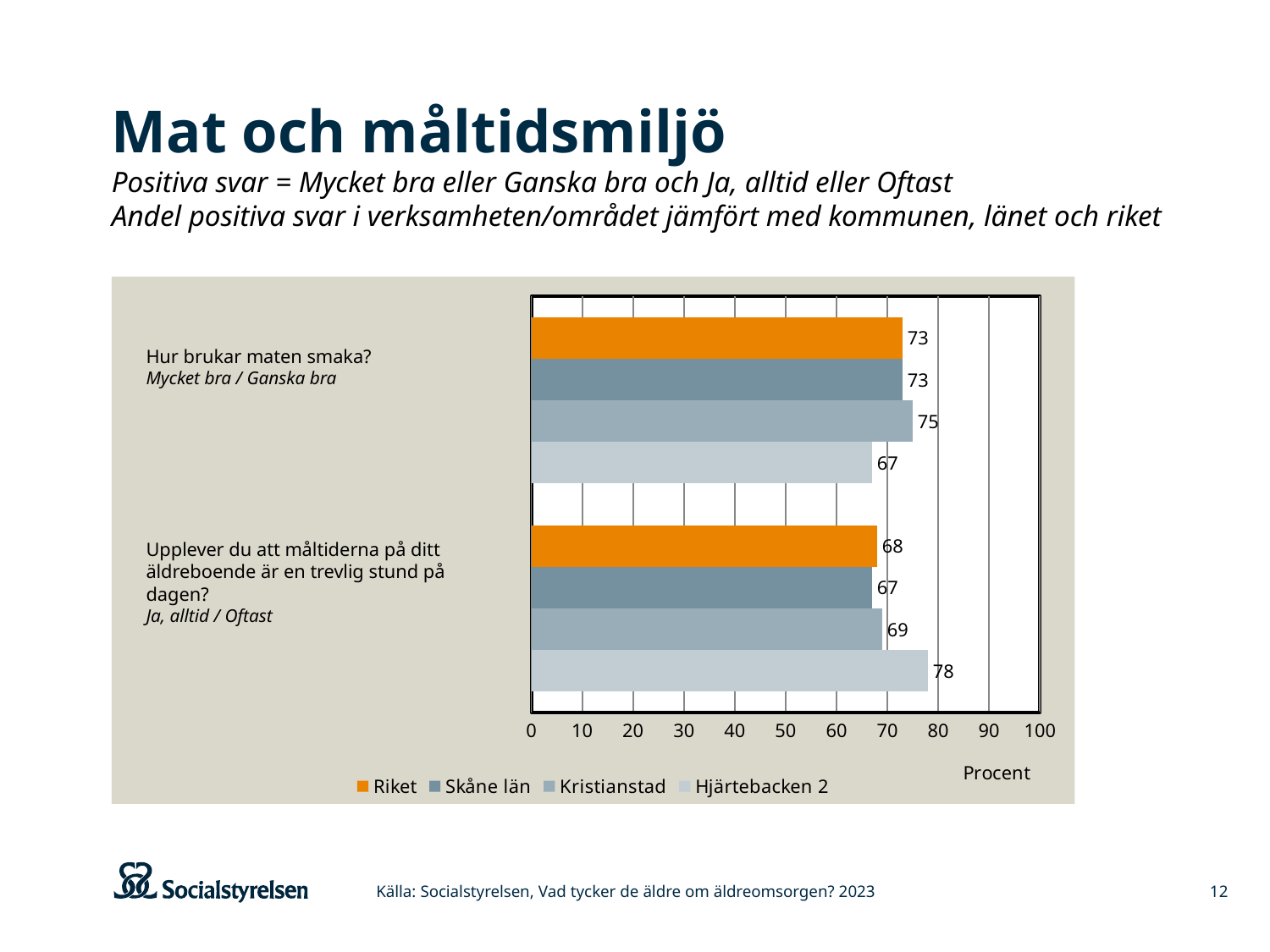
What is the label of the x axis? Procent What is the value for Riket for the question "Hur brukar maten smaka?"? 73 Which series has the highest value for the question "Upplever du att måltiderna på ditt äldreboende är en trevlig stund på dagen?"? Hjärtebacken 2 What is the value for Kristianstad for the question "Hur brukar maten smaka?"? 75 What is the value for Hjärtebacken 2 for the question "Upplever du att måltiderna på ditt äldreboende är en trevlig stund på dagen?"? 78 What is the difference between the Hjärtebacken 2 and Riket values for the question "Upplever du att måltiderna på ditt äldreboende är en trevlig stund på dagen?"? 10 Which series has the lowest value for the question "Hur brukar maten smaka?"? Hjärtebacken 2 What is the value for Skåne län for the question "Upplever du att måltiderna på ditt äldreboende är en trevlig stund på dagen?"? 67 For Hjärtebacken 2, which question has the larger value: "Hur brukar maten smaka?" or "Upplever du att måltiderna på ditt äldreboende är en trevlig stund på dagen?"? Upplever du att måltiderna på ditt äldreboende är en trevlig stund på dagen? What kind of chart is shown on the slide? bar chart What is the difference between the Kristianstad and Hjärtebacken 2 values for the question "Hur brukar maten smaka?"? 8 How many series does the legend list? 4